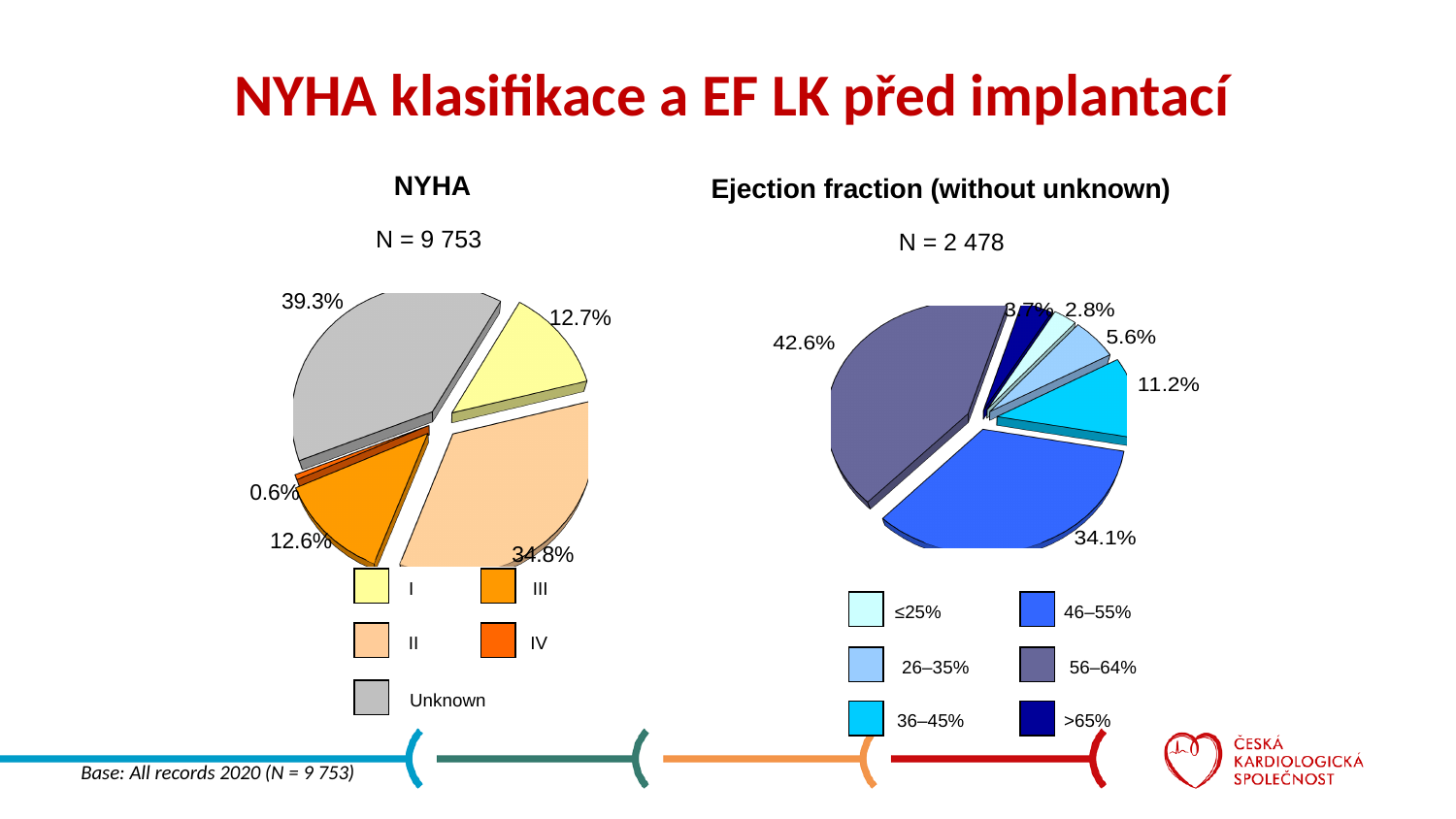
In the NYHA pie chart, what is the difference between the shares of class II and class III? 22.2% In the NYHA pie chart, what percentage of records are NYHA class II? 34.8% In the NYHA pie chart, what share is labelled Unknown? 39.3% In the NYHA pie chart, which category has the largest share? Unknown In the NYHA pie chart, what percentage is NYHA class IV? 0.6% In the Ejection fraction pie chart, which is larger: the 46–55% category or the 26–35% category? 46–55% In the Ejection fraction pie chart, what percentage falls in the 36–45% category? 11.2% In the NYHA pie chart, which category has the smallest share? IV How many categories does the legend of the Ejection fraction pie chart list? 6 What type of chart is used for the NYHA data? Pie chart In the Ejection fraction pie chart, what percentage falls in the 56–64% category? 42.6% In the Ejection fraction pie chart, which category has the largest share? 56–64%